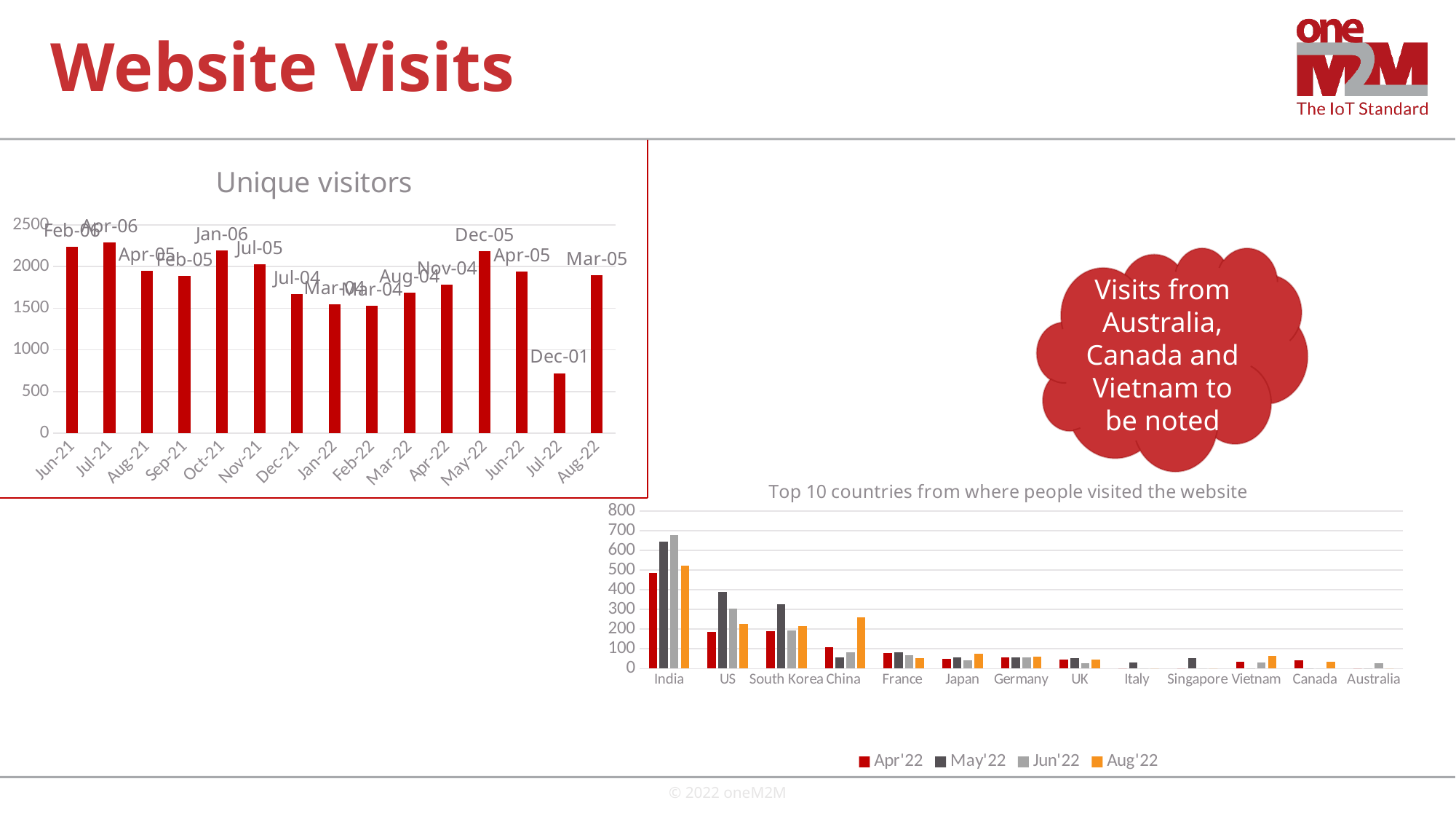
In the 'Top 10 countries from where people visited the website' chart, how many series does the legend list? 4 In the 'Top 10 countries from where people visited the website' chart, which is larger for China, the Apr'22 value or the Aug'22 value? Aug'22 In the 'Unique visitors' chart, which month has the lowest number of unique visitors? Jul-22 In the 'Unique visitors' chart, how many months are shown on the x axis? 15 In the 'Top 10 countries from where people visited the website' chart, how many countries are shown on the x axis? 13 In the 'Unique visitors' chart, is the value for Jun-21 greater or less than 2000? greater What type of chart is the 'Unique visitors' chart? bar chart In the 'Top 10 countries from where people visited the website' chart, is the Jun'22 value for India greater or less than 600? greater In the 'Unique visitors' chart, which is larger, the value for May-22 or the value for Jul-22? May-22 In the 'Top 10 countries from where people visited the website' chart, which country has the highest Jun'22 value? India In the 'Unique visitors' chart, is the value for Aug-22 greater or less than 2000? less